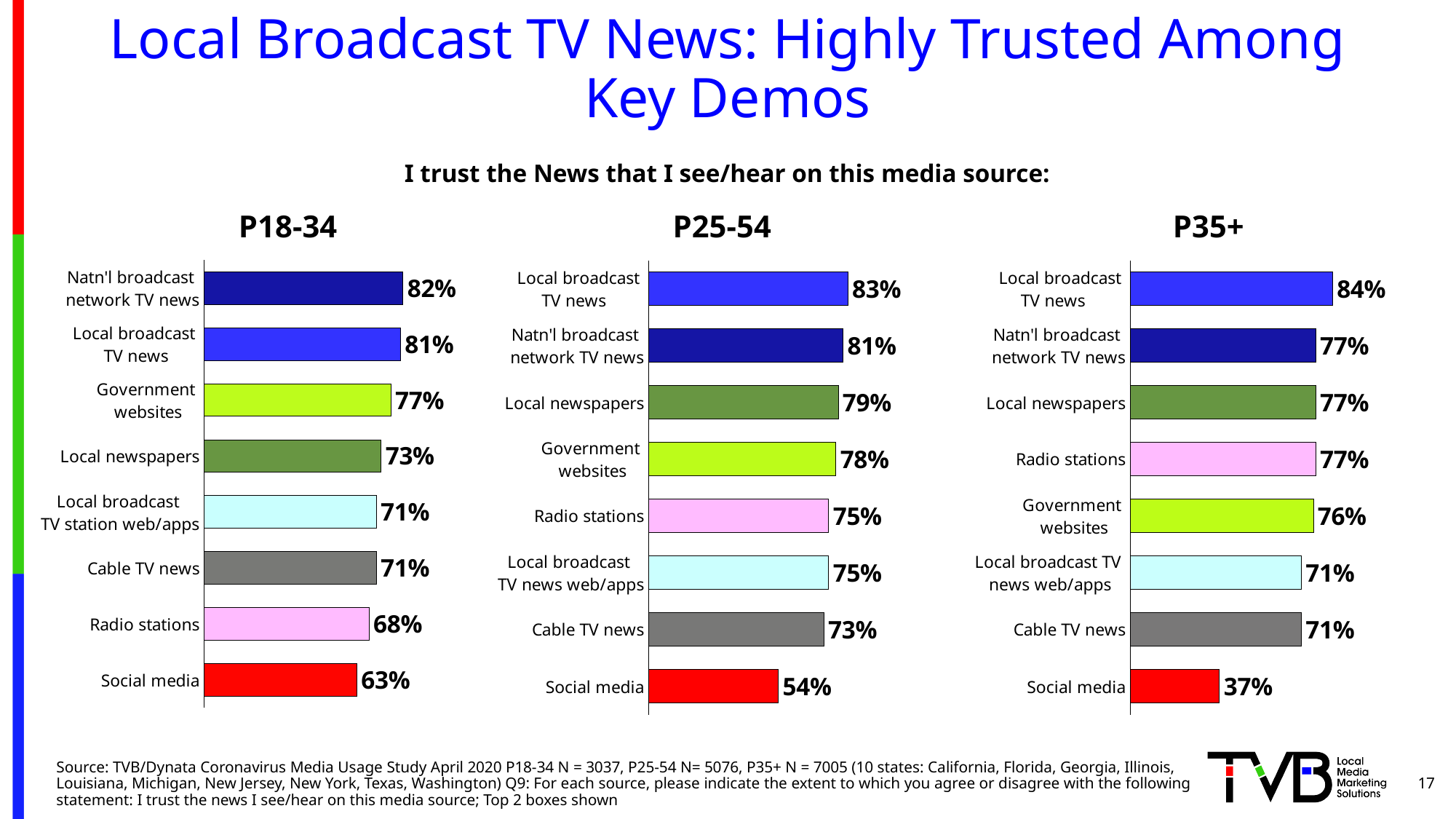
In the P25-54 chart, which media source has the lowest value? Social media In the P35+ chart, which media source has the highest value? Local broadcast TV news What colour is the Social media bar in each chart? Red In the P25-54 chart, which is larger: Government websites or Cable TV news? Government websites What kind of chart is used for the P25-54 data? Bar chart In the P18-34 chart, what percentage trust the news on Natn'l broadcast network TV news? 82% In the P35+ chart, what is the value for Social media? 37% How many media sources are shown in the P18-34 chart? 8 In the P25-54 chart, what is the value for Local newspapers? 79% In the P35+ chart, what is the difference between Local broadcast TV news and Natn'l broadcast network TV news? 7% In the P18-34 chart, what is the value for Radio stations? 68% In the P18-34 chart, what is the difference between Natn'l broadcast network TV news and Social media? 19%